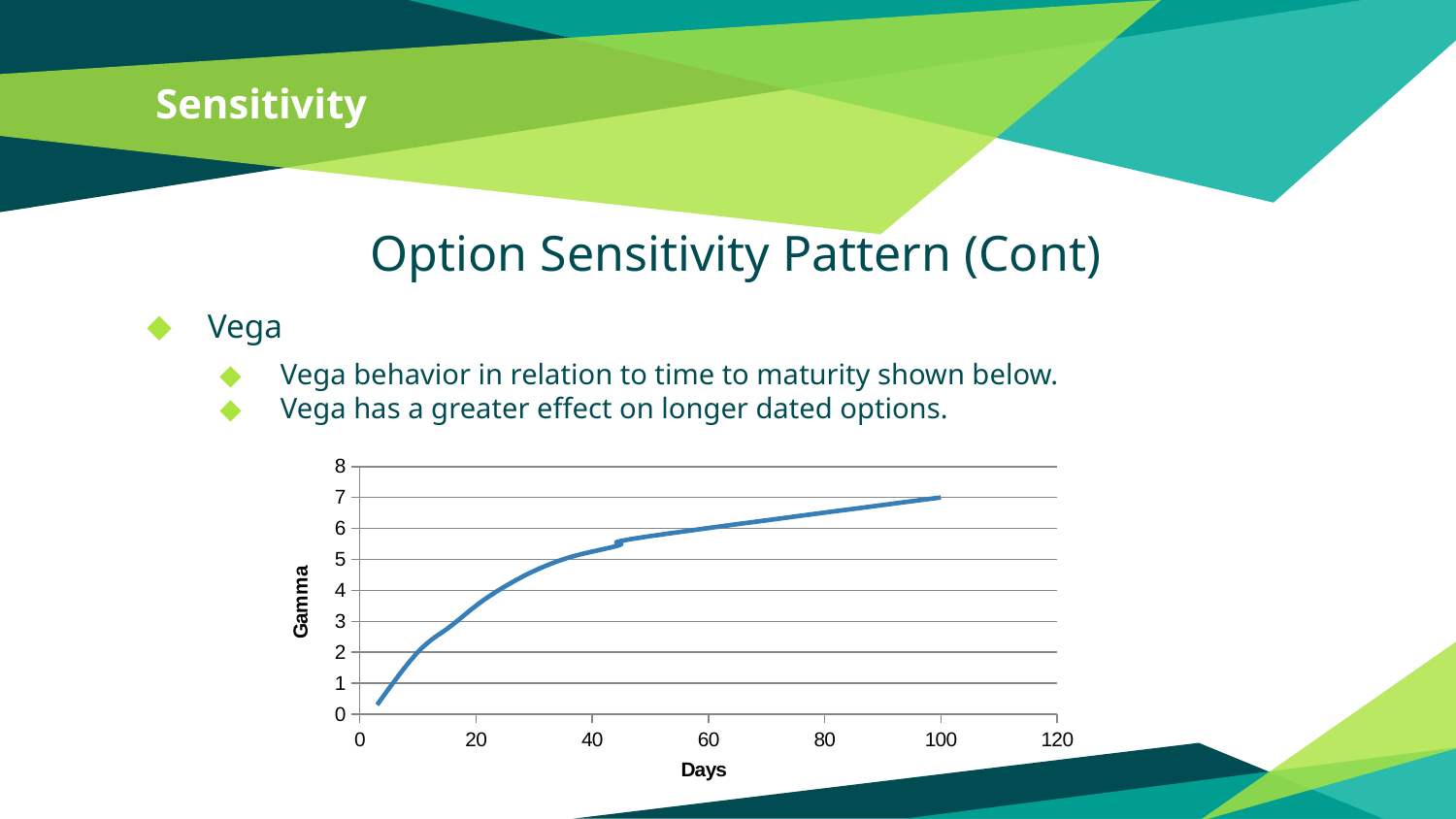
Is the value of the line at 60 days greater or less than 5? greater Is the value of the line at 40 days greater or less than 6? less What is the label of the y axis of the chart? Gamma Is the value of the line at 10 days greater or less than 3? less What is the value of the line at 100 days, where it ends? 7 What is the label of the x axis of the chart? Days How many lines are plotted on the chart? 1 Does the plotted line rise or fall as Days increase along the x axis? rise What kind of chart is shown on the slide? line chart